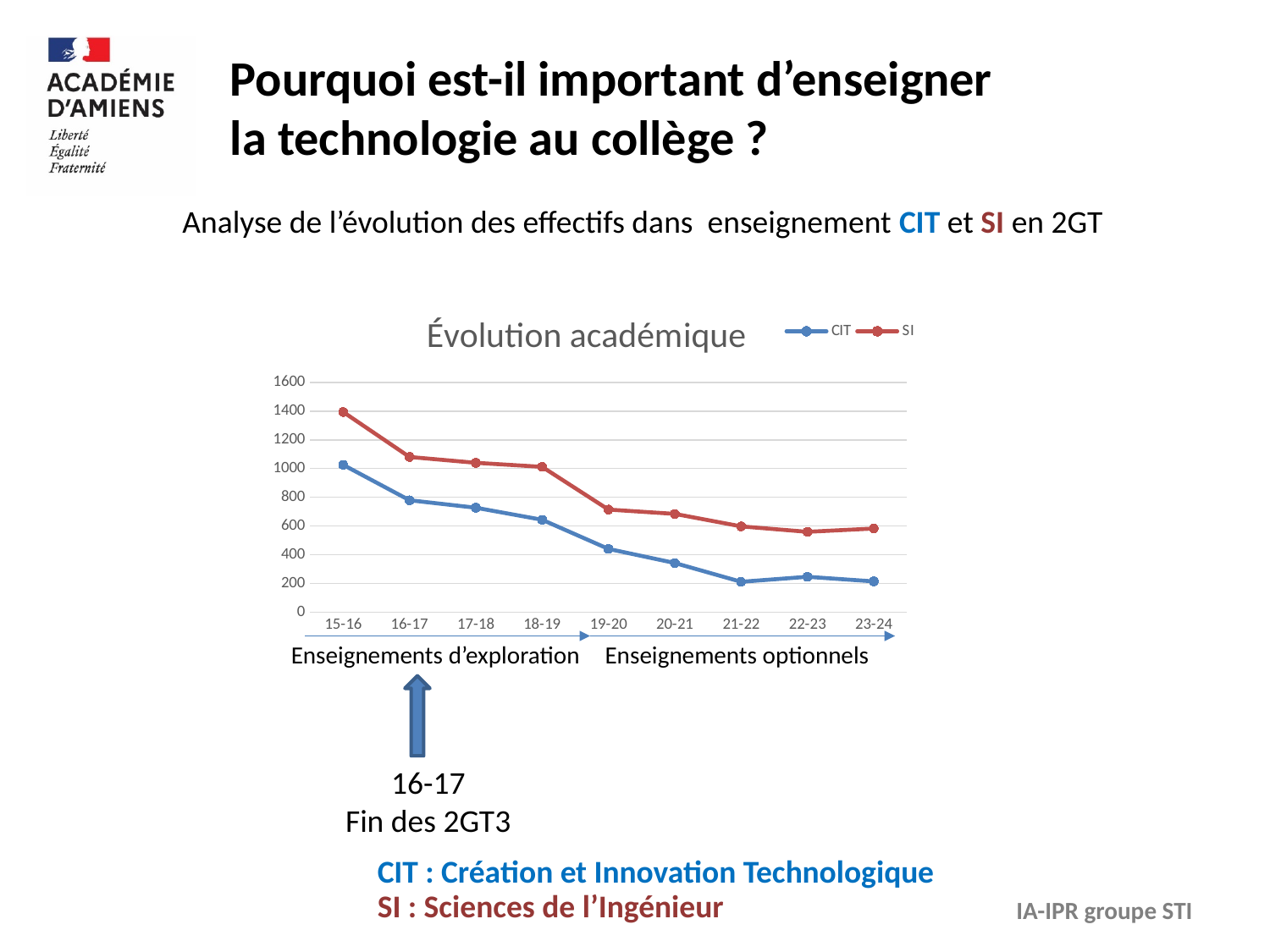
What kind of chart is shown on the slide? line chart What is the title of the chart? Évolution académique In which school year is the SI series at its highest? 15-16 Is the value for CIT in 23-24 greater or less than 400? less How many series does the chart's legend list? 2 Do the CIT values generally rise or fall from 15-16 to 23-24? fall How many school years are plotted along the x axis? 9 Is the value for CIT in 20-21 greater or less than 400? less Is the value for SI in 15-16 greater or less than 1200? greater Which series is higher in 19-20, CIT or SI? SI